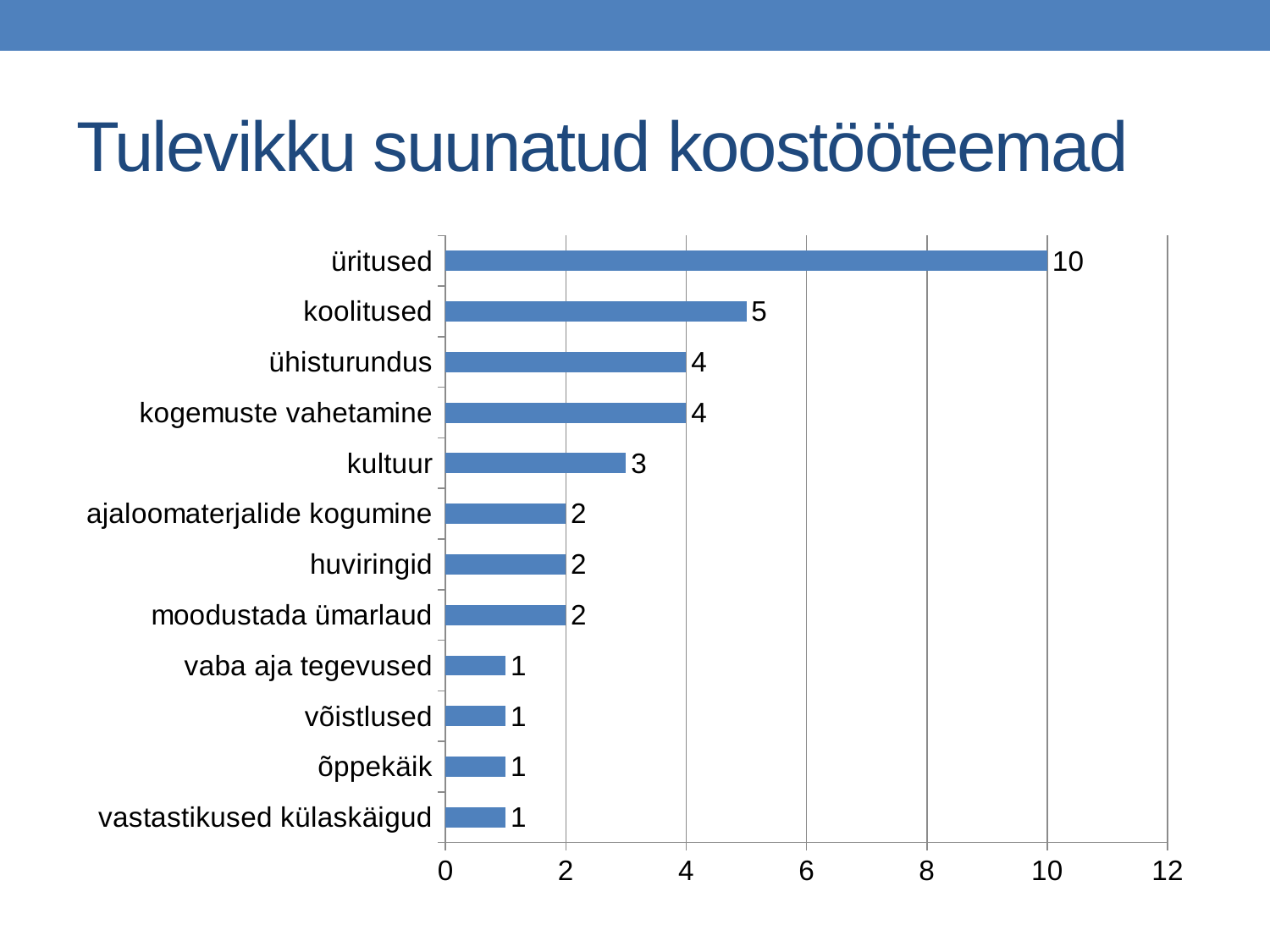
What is the difference between the values for üritused and koolitused? 5 What is the value for koolitused? 5 Is the value for üritused greater or less than 8? greater What is the value for üritused? 10 What kind of chart is shown on the slide? bar chart What is the value for kultuur? 3 What is the title of the slide? Tulevikku suunatud koostööteemad What is the difference between the values for kogemuste vahetamine and moodustada ümarlaud? 2 Which category has the highest value? üritused What is the value for huviringid? 2 How many categories are shown in the chart? 12 Which is larger, the value for ühisturundus or the value for kultuur? ühisturundus